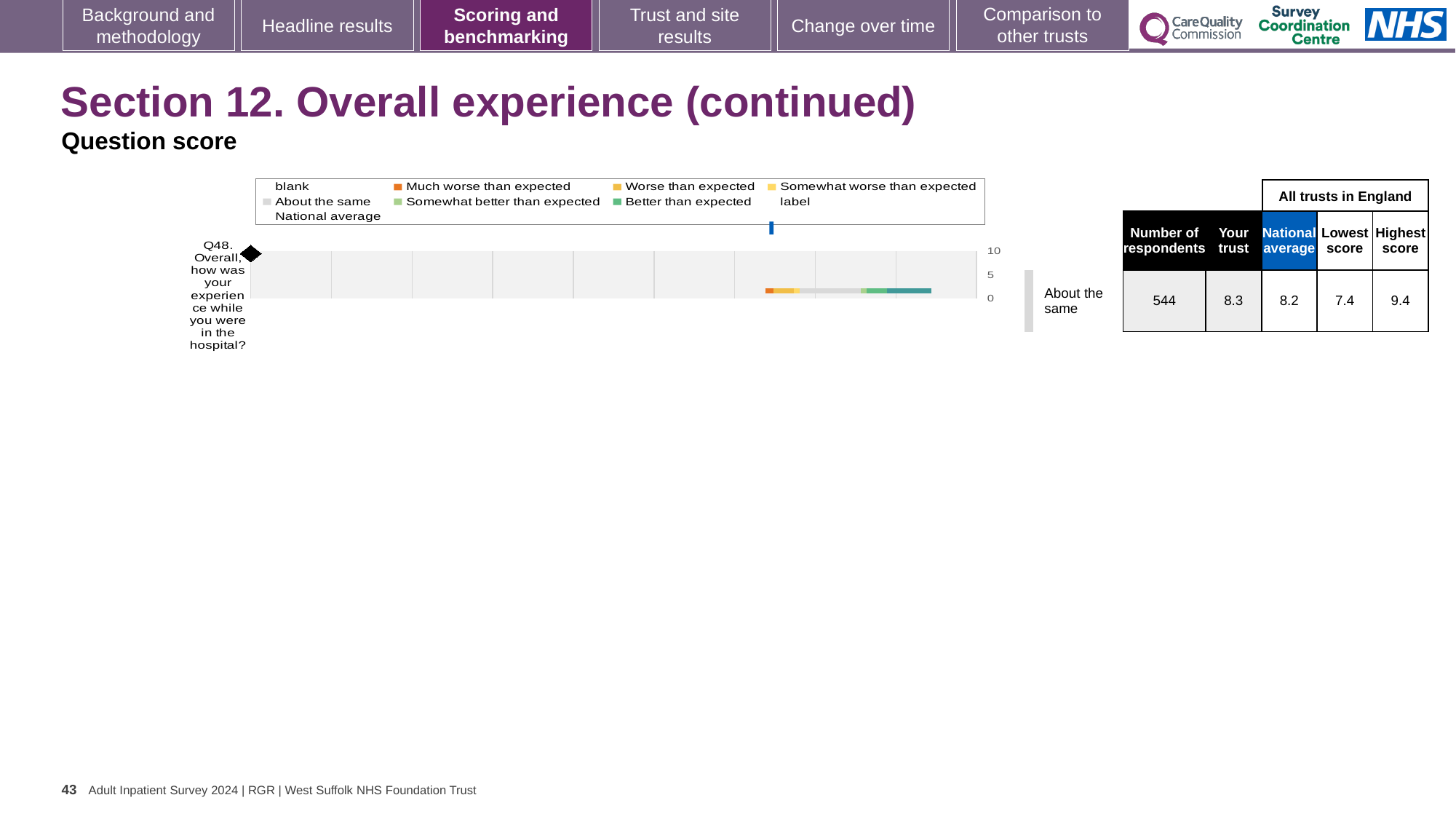
According to the table beside the chart, what is the lowest score among all trusts in England for Q48? 7.4 According to the table beside the chart, what is the highest score among all trusts in England for Q48? 9.4 What benchmark category is the trust's Q48 result labelled as next to the chart? About the same Which question is plotted in the chart? Q48. Overall, how was your experience while you were in the hospital? What is the difference between the 'Your trust' score and the national average score for Q48? 0.1 According to the table beside the chart, what is the number of respondents for Q48? 544 How many questions (categories) are plotted in the chart? 1 According to the table beside the chart, what is the 'Your trust' score for Q48? 8.3 What is the highest value shown on the chart's axis? 10 What kind of chart is shown on the slide? bar chart According to the table beside the chart, what is the national average score for Q48? 8.2 Is the 'Your trust' score or the national average score higher for Q48? Your trust